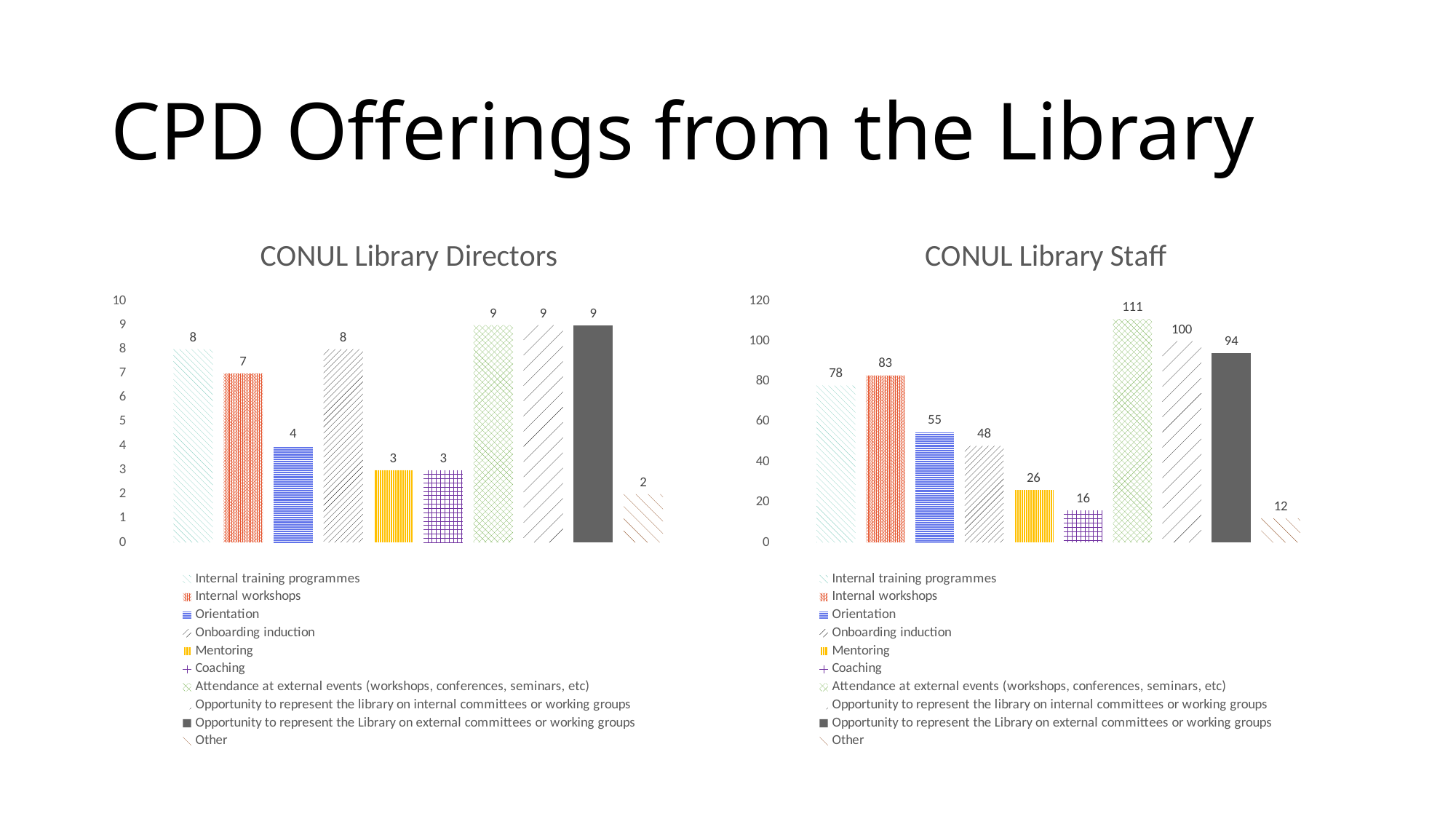
In the CONUL Library Staff chart, which category has the lowest value? Other In the CONUL Library Directors chart, what is the difference between Onboarding induction and Mentoring? 5 In the CONUL Library Staff chart, what is the value for Coaching? 16 How many categories are shown in the CONUL Library Staff chart? 10 In the CONUL Library Directors chart, what is the value for Orientation? 4 In the CONUL Library Staff chart, what is the value for Internal workshops? 83 What type of chart is the CONUL Library Directors chart? Bar chart In the CONUL Library Directors chart, which category has the lowest value? Other In the CONUL Library Staff chart, what is the difference between Internal workshops and Internal training programmes? 5 In the CONUL Library Staff chart, which category has the highest value? Attendance at external events (workshops, conferences, seminars, etc) In the CONUL Library Staff chart, which is larger: Orientation or Onboarding induction? Orientation In the CONUL Library Directors chart, which is larger: Internal workshops or Orientation? Internal workshops